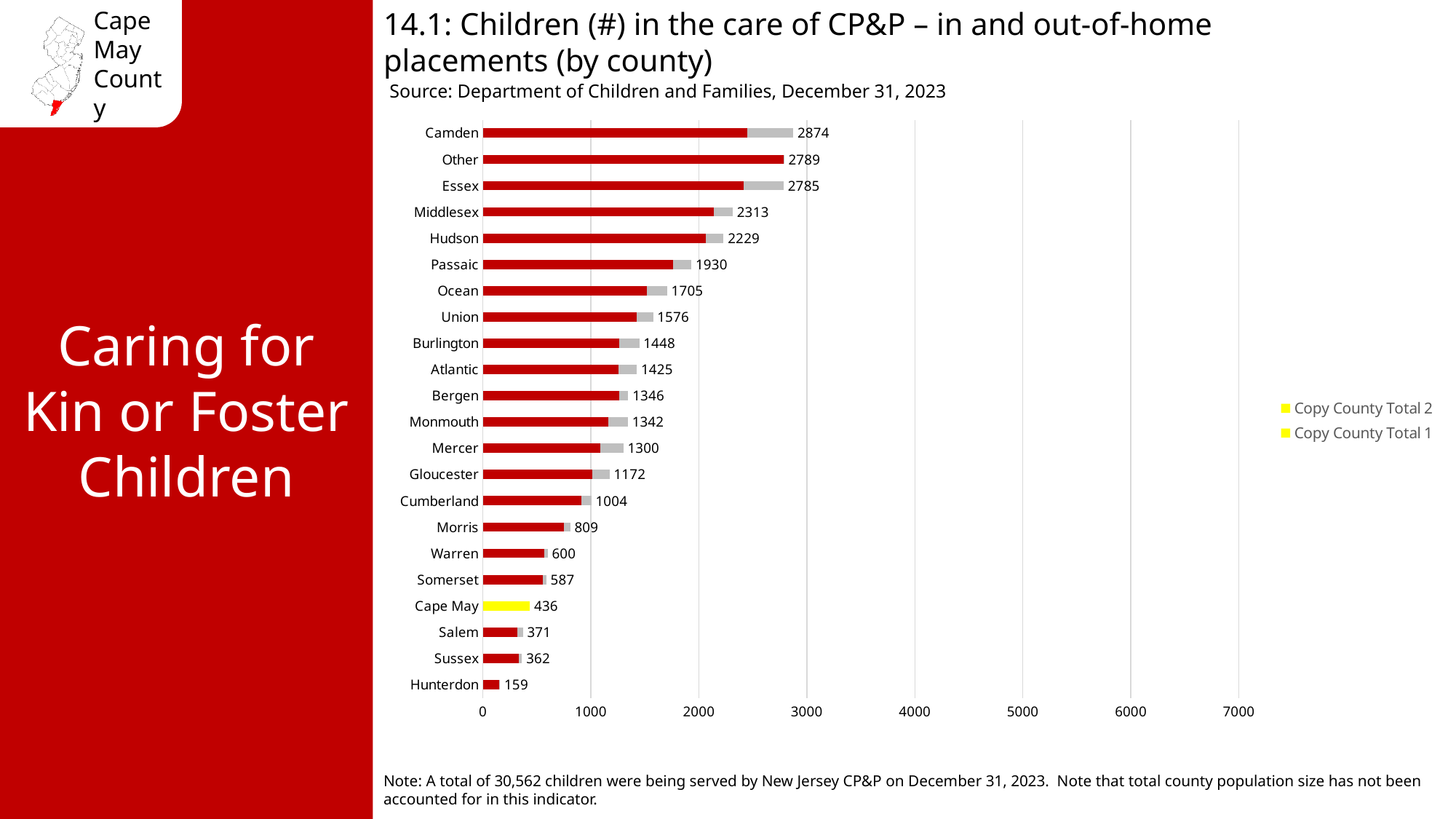
Which has a larger total, Passaic or Ocean? Passaic What is the difference between the totals for Cape May and Salem? 65 What is the total number of children in the care of CP&P for Cape May County? 436 What is the total value shown for Camden? 2874 What kind of chart is shown on the slide? Bar chart How many series does the legend list? 2 What is the total value shown for Hunterdon? 159 Is the total for Middlesex greater or less than 2000? greater What is the difference between the totals for Camden and Hunterdon? 2715 Which county has the lowest total number of children in the care of CP&P? Hunterdon How many counties/categories are shown on the chart? 22 Which county has the highest total number of children in the care of CP&P? Camden